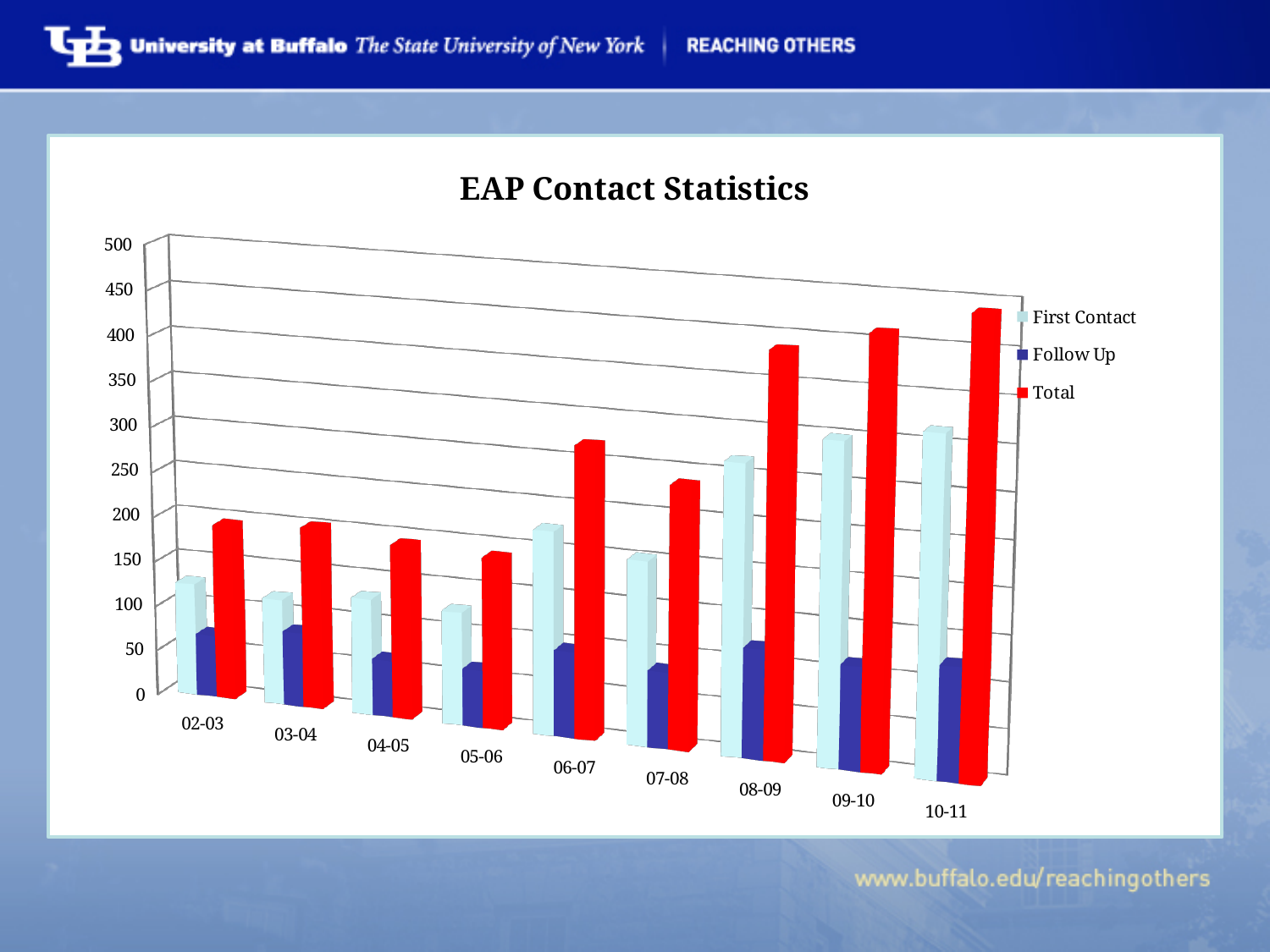
In which year is the Total value highest? 10-11 How many academic years are shown on the x axis? 9 Is the Total value for 10-11 greater or less than 400? greater Which year has the larger Total value, 06-07 or 07-08? 06-07 What type of chart is shown on the slide? bar chart Does the Total value rise or fall from 07-08 to 10-11? rise Which series is shown in red? Total How many series does the legend list? 3 What is the title of the chart? EAP Contact Statistics In which year is the Total value lowest? 05-06 Is the Follow Up value for 05-06 greater or less than 50? less